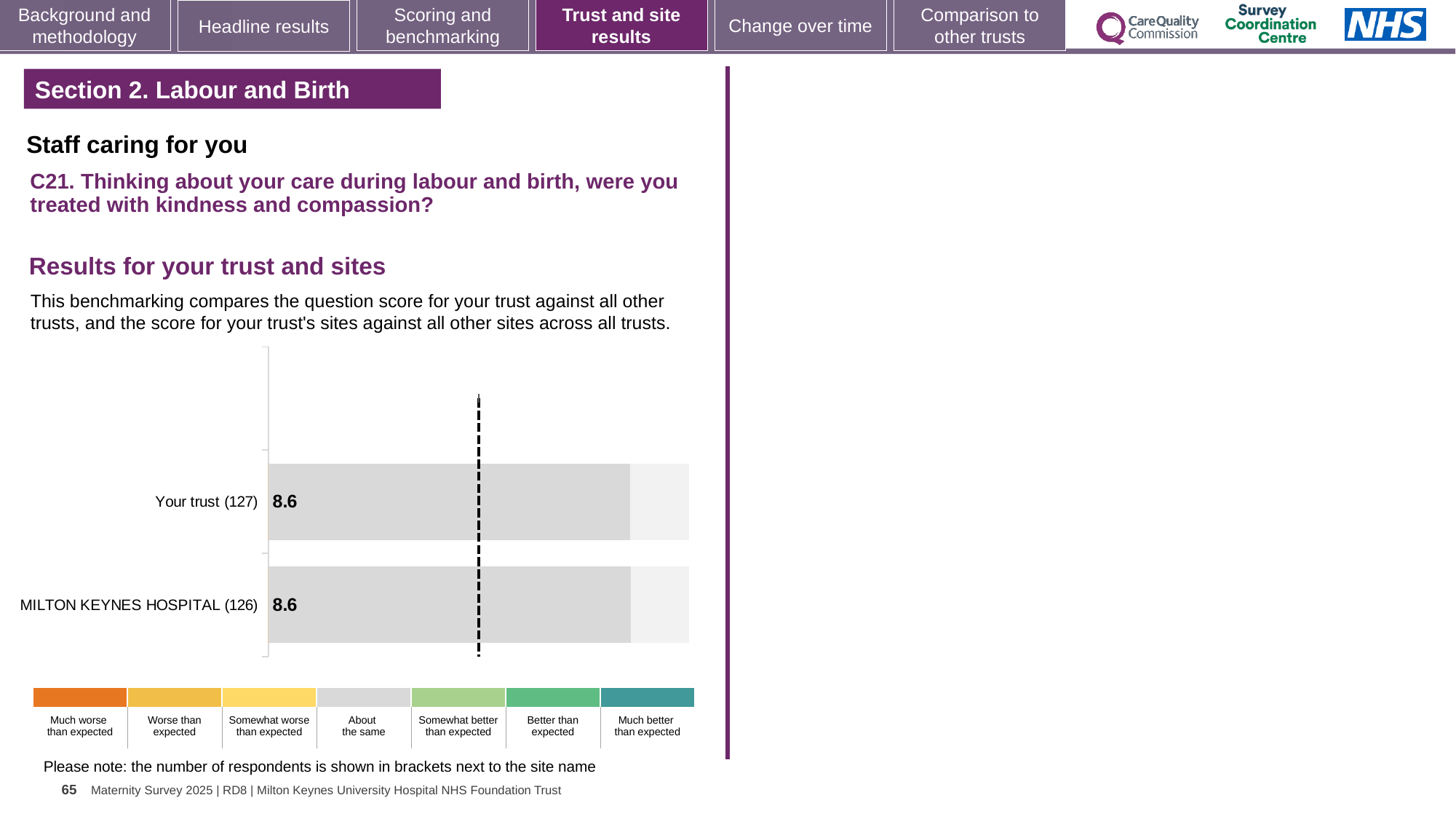
What is the difference between the score for Your trust and the score for MILTON KEYNES HOSPITAL? 0 How many respondents are shown in brackets for MILTON KEYNES HOSPITAL? 126 How many benchmark categories does the colour key below the chart list? 7 Is the score for Your trust (127) greater or less than 5? greater How many bars are plotted in the chart? 2 What is the score for MILTON KEYNES HOSPITAL (126)? 8.6 Which benchmark category does the grey colour of the bars correspond to in the key? About the same What is the score for Your trust (127)? 8.6 What kind of chart is shown on the slide? Bar chart How many respondents are shown in brackets for Your trust? 127